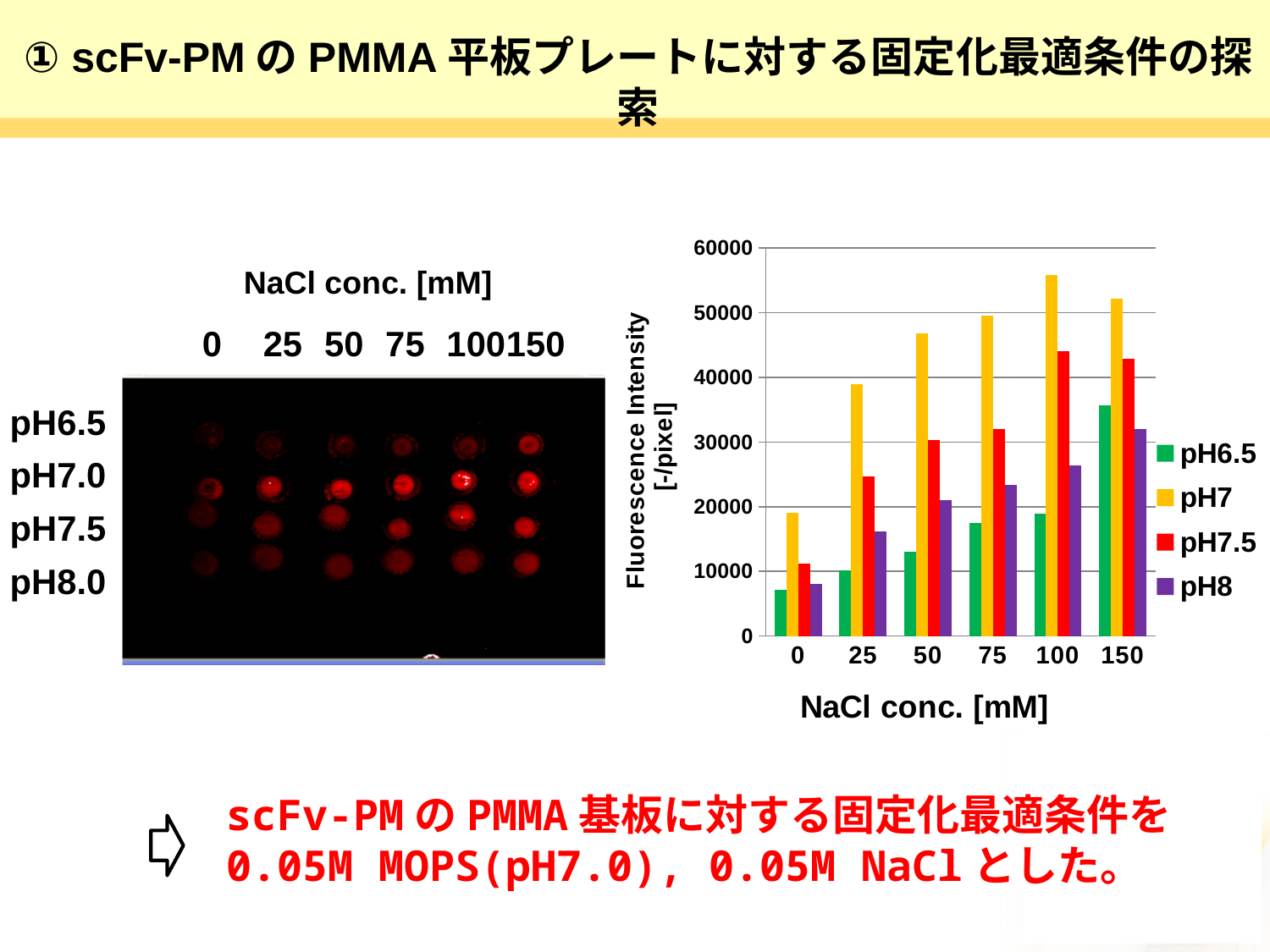
At which NaCl concentration is the pH7 bar highest? 100 How many series does the legend of the chart list? 4 Is the value for pH7 at 100 mM NaCl greater or less than 50000? greater Is the value for pH6.5 at 0 mM NaCl greater or less than 10000? less At which NaCl concentration is the pH6.5 bar lowest? 0 How many NaCl concentration categories are shown on the x axis of the chart? 6 What kind of chart is shown on the slide? bar chart What is the title of the x axis of the chart? NaCl conc. [mM] What is the title of the y axis of the chart? Fluorescence Intensity [-/pixel] Is the value for pH8 at 100 mM NaCl greater or less than 30000? less Do the pH7.5 values rise or fall as NaCl concentration increases from 0 to 100 mM? rise At 150 mM NaCl, which is larger, the pH7 bar or the pH7.5 bar? pH7